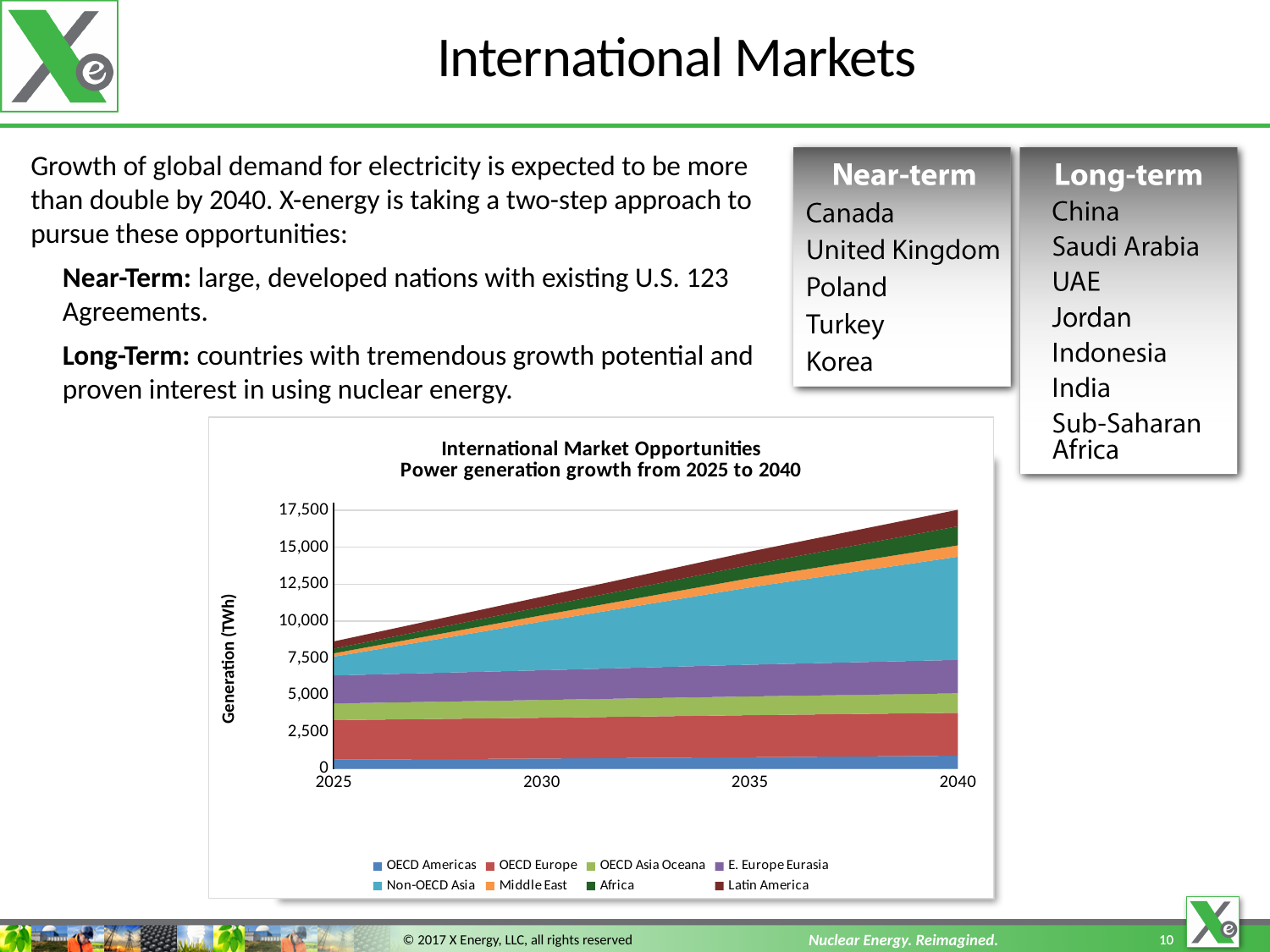
Which series occupies the largest area in the chart? Non-OECD Asia How many series does the chart legend list? 8 Does total generation rise or fall from 2025 to 2040 in the chart? Rise Is the total stacked generation in 2025 greater or less than 10,000? less Is the total stacked generation in 2030 greater or less than 10,000? greater How many years are labelled on the x axis of the chart? 4 In 2040, which is larger in the chart: Non-OECD Asia or OECD Americas? Non-OECD Asia What is the title of the chart? International Market Opportunities Power generation growth from 2025 to 2040 Which series shows the largest growth between 2025 and 2040 in the chart? Non-OECD Asia Is the total stacked generation in 2040 greater or less than 15,000? greater What is the label of the vertical axis of the chart? Generation (TWh) What kind of chart is shown on the slide? Stacked area chart